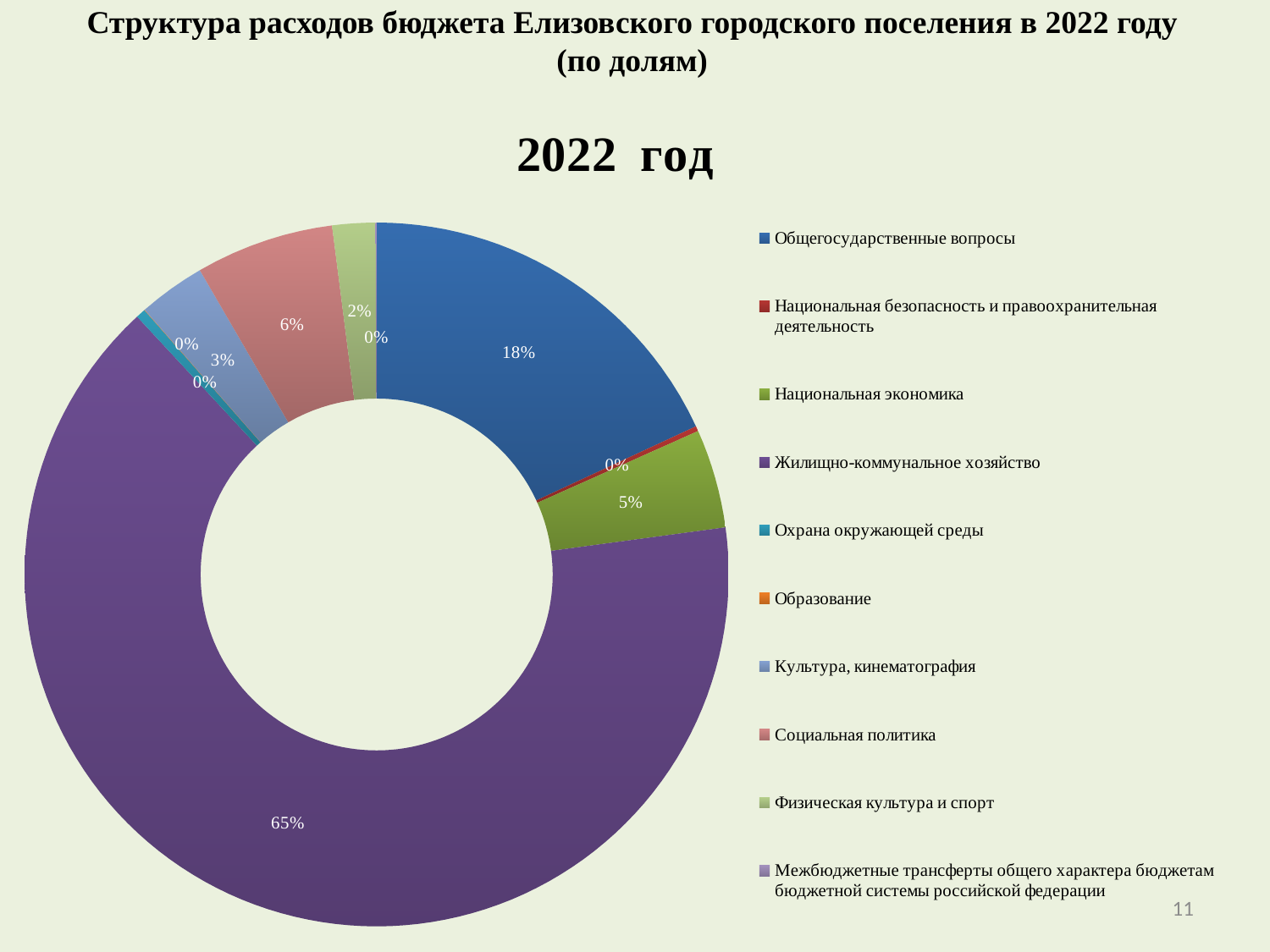
What share is shown for Культура, кинематография? 3% What share is shown for Общегосударственные вопросы? 18% What is the difference in percentage points between Жилищно-коммунальное хозяйство and Общегосударственные вопросы? 47 percentage points What share is shown for Национальная экономика? 5% How many categories does the legend list? 10 What is the title shown above the chart? 2022 год What share of the 2022 budget expenditure goes to Жилищно-коммунальное хозяйство? 65% Which has a larger share: Социальная политика or Национальная экономика? Социальная политика What share is shown for Физическая культура и спорт? 2% Which category has the largest share of expenditure? Жилищно-коммунальное хозяйство What share is shown for Социальная политика? 6% What kind of chart is shown on the slide? Doughnut (pie) chart